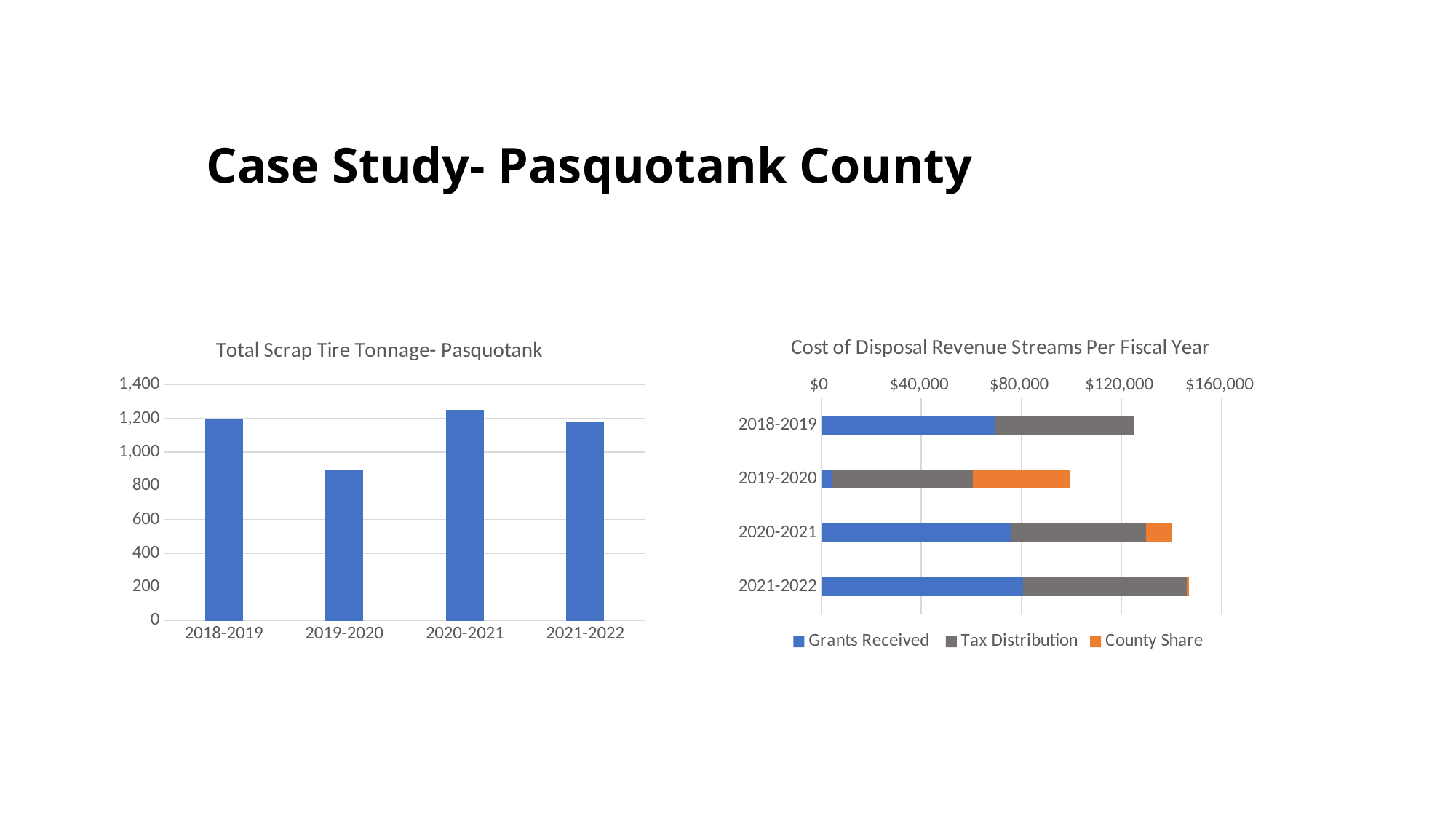
How many series does the legend of the 'Cost of Disposal Revenue Streams Per Fiscal Year' chart list? 3 In the 'Total Scrap Tire Tonnage- Pasquotank' chart, is the value for 2019-2020 greater or less than 1,000? less In the 'Total Scrap Tire Tonnage- Pasquotank' chart, which is larger, the value for 2018-2019 or 2019-2020? 2018-2019 What are the legend entries in the 'Cost of Disposal Revenue Streams Per Fiscal Year' chart? Grants Received, Tax Distribution, County Share In the 'Total Scrap Tire Tonnage- Pasquotank' chart, which fiscal year has the lowest tonnage? 2019-2020 In the 'Total Scrap Tire Tonnage- Pasquotank' chart, is the value for 2020-2021 greater or less than 1,200? greater In the 'Cost of Disposal Revenue Streams Per Fiscal Year' chart, is the Grants Received value for 2019-2020 greater or less than $40,000? less What kind of chart is the 'Total Scrap Tire Tonnage- Pasquotank' chart? bar chart In the 'Total Scrap Tire Tonnage- Pasquotank' chart, which fiscal year has the highest tonnage? 2020-2021 How many fiscal years are shown in the 'Total Scrap Tire Tonnage- Pasquotank' chart? 4 In the 'Cost of Disposal Revenue Streams Per Fiscal Year' chart, which fiscal year has the largest County Share segment? 2019-2020